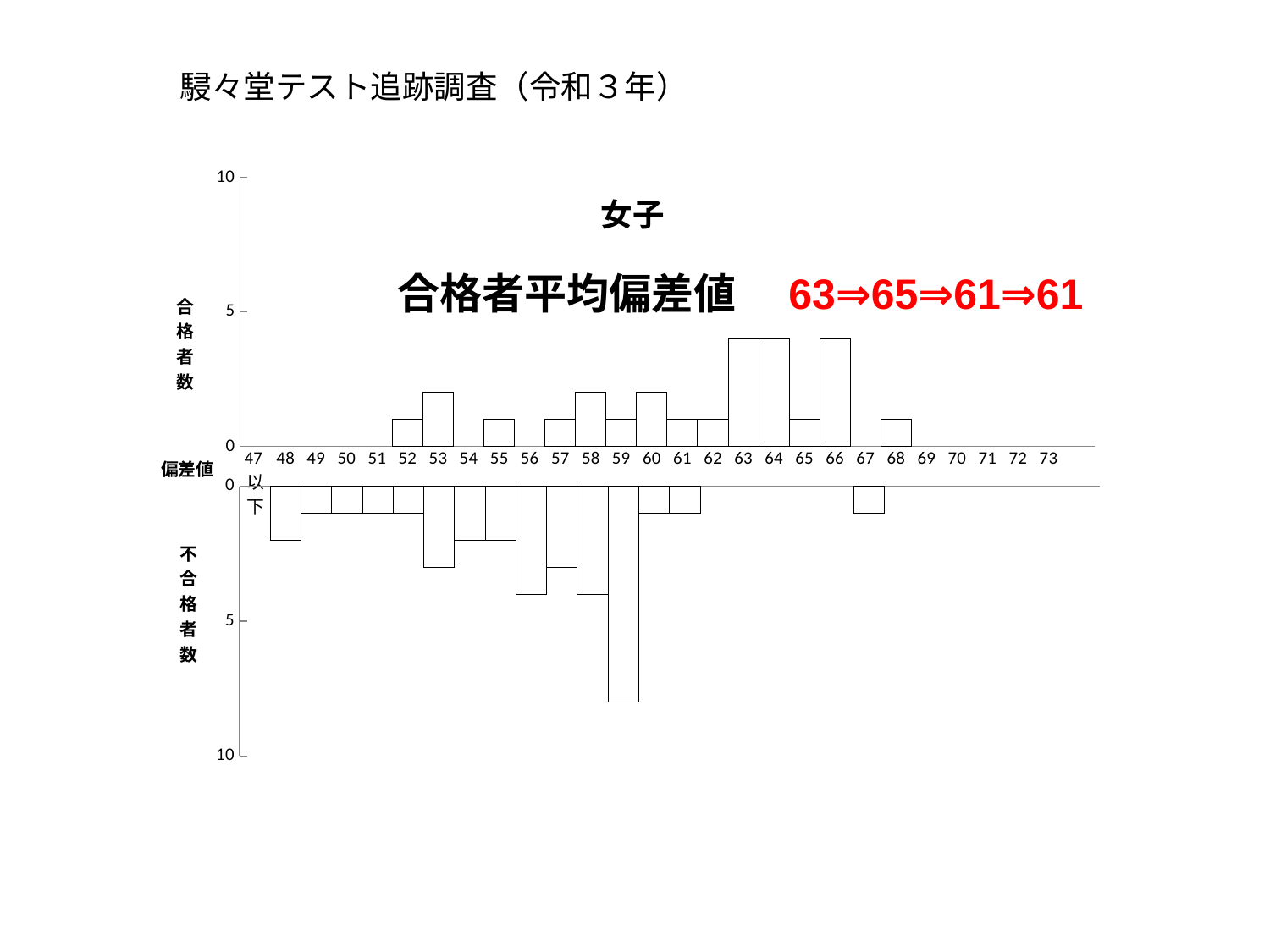
How many 偏差値 categories are labelled along the x axis? 27 What sequence of values is printed in red after 合格者平均偏差値? 63⇒65⇒61⇒61 What kind of chart is shown on the slide? bar chart In the lower 不合格者数 part of the chart, is the value for 偏差値 58 greater or less than 5? less What is the title printed at the top of the slide? 駿々堂テスト追跡調査（令和３年） In the lower 不合格者数 part of the chart, which has more failures, 偏差値 59 or 偏差値 58? 59 In the lower 不合格者数 part of the chart, which has more failures, 偏差値 56 or 偏差値 55? 56 In the upper 合格者数 part of the chart, which has more passers, 偏差値 66 or 偏差値 67? 66 In the upper 合格者数 part of the chart, is the value for 偏差値 63 greater or less than 5? less In the lower 不合格者数 part of the chart, is the value for 偏差値 59 greater or less than 5? greater In the lower 不合格者数 part of the chart, which 偏差値 has the highest number of failures? 59